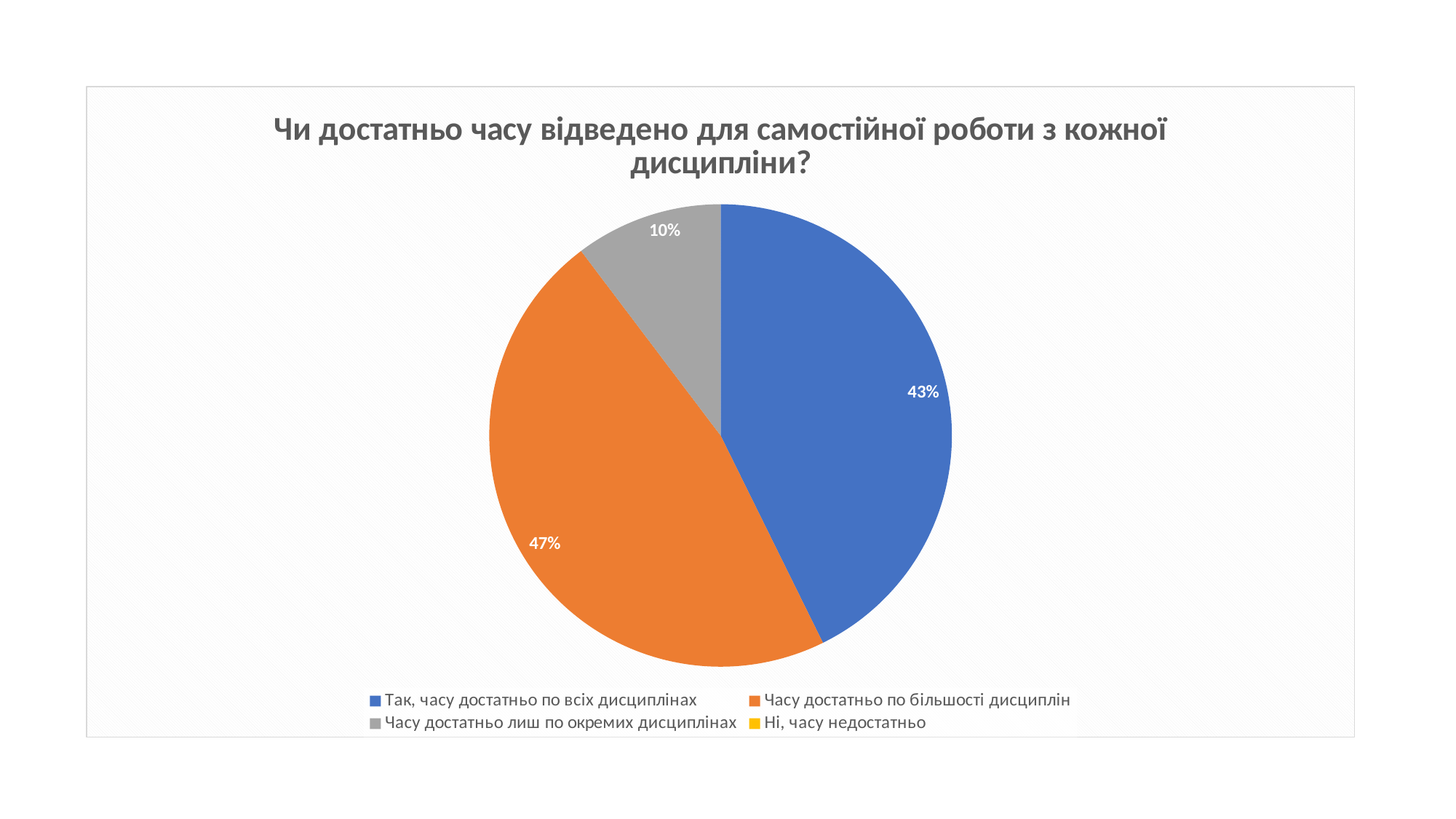
How many slices with data labels are visible in the pie? 3 What percentage is shown for "Часу достатньо лиш по окремих дисциплінах"? 10% What share of the pie does the grey slice represent? 10% What kind of chart is shown on the slide? Pie chart What percentage of the pie corresponds to "Так, часу достатньо по всіх дисциплінах"? 43% Which is larger: the slice for "Так, часу достатньо по всіх дисциплінах" or the slice for "Часу достатньо по більшості дисциплін"? Часу достатньо по більшості дисциплін What colour is the slice for "Так, часу достатньо по всіх дисциплінах"? Blue What percentage is shown for "Часу достатньо по більшості дисциплін"? 47% Which category has the largest slice of the pie? Часу достатньо по більшості дисциплін What is the difference in percentage points between the "Часу достатньо по більшості дисциплін" slice and the "Так, часу достатньо по всіх дисциплінах" slice? 4 percentage points What is the title of the chart? Чи достатньо часу відведено для самостійної роботи з кожної дисципліни? How many categories does the legend list? 4